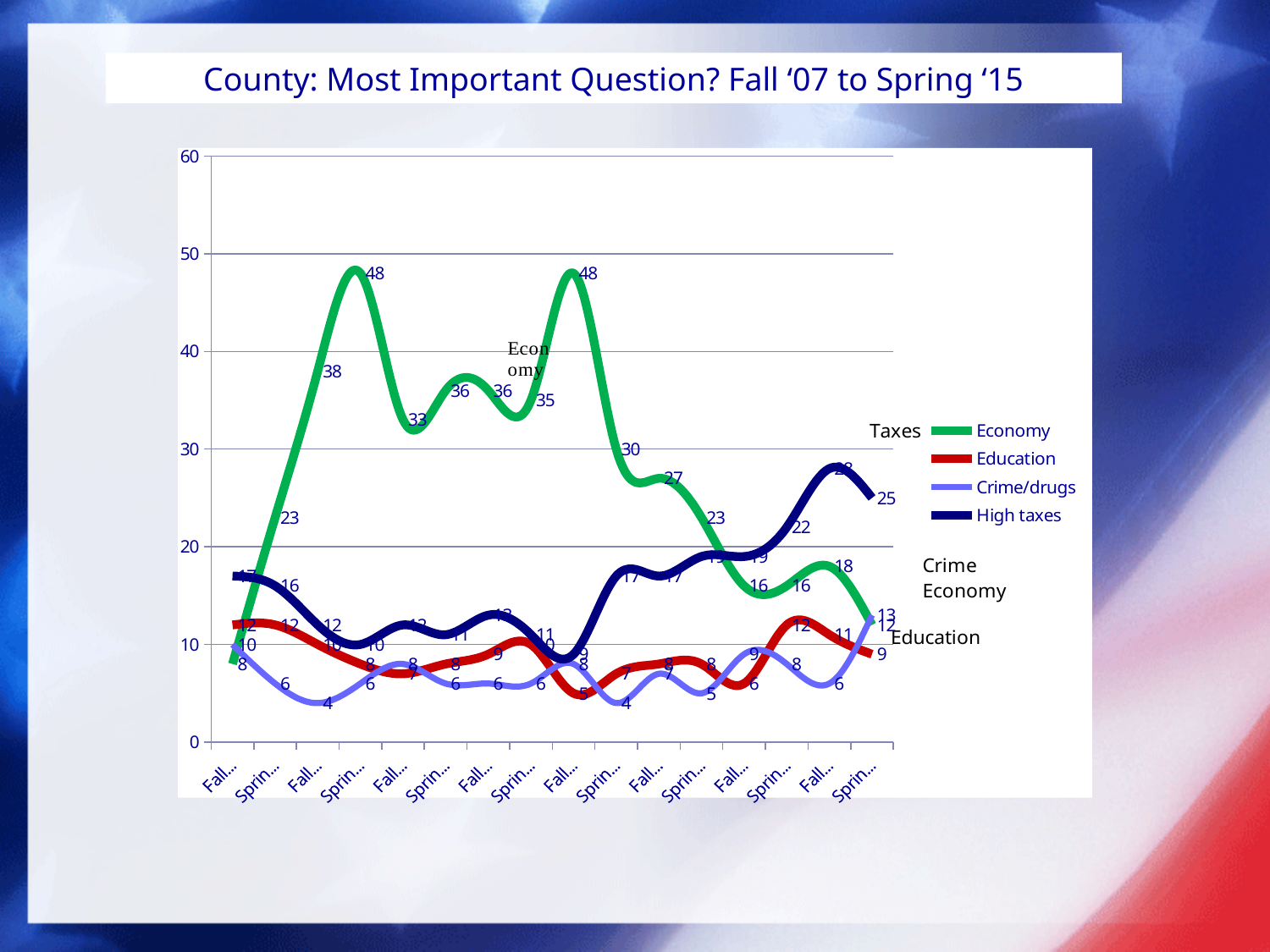
What is the title of the chart? County: Most Important Question? Fall '07 to Spring '15 Which series is drawn in green according to the legend? Economy What kind of chart is shown on the slide? line chart Is the peak value of the Economy series greater or less than 40? greater What is the lowest value shown for the Crime/drugs series? 4 How many series does the legend list? 4 What is the difference between the High taxes value and the Economy value at the last point on the x axis? 13 At the last point on the x axis, which is larger: the Economy value or the High taxes value? High taxes What is the value of the Economy series at the last point on the x axis? 12 How many data points does each series have along the x axis? 16 What is the value of the High taxes series at the last point on the x axis? 25 What is the highest value reached by the Economy series? 48